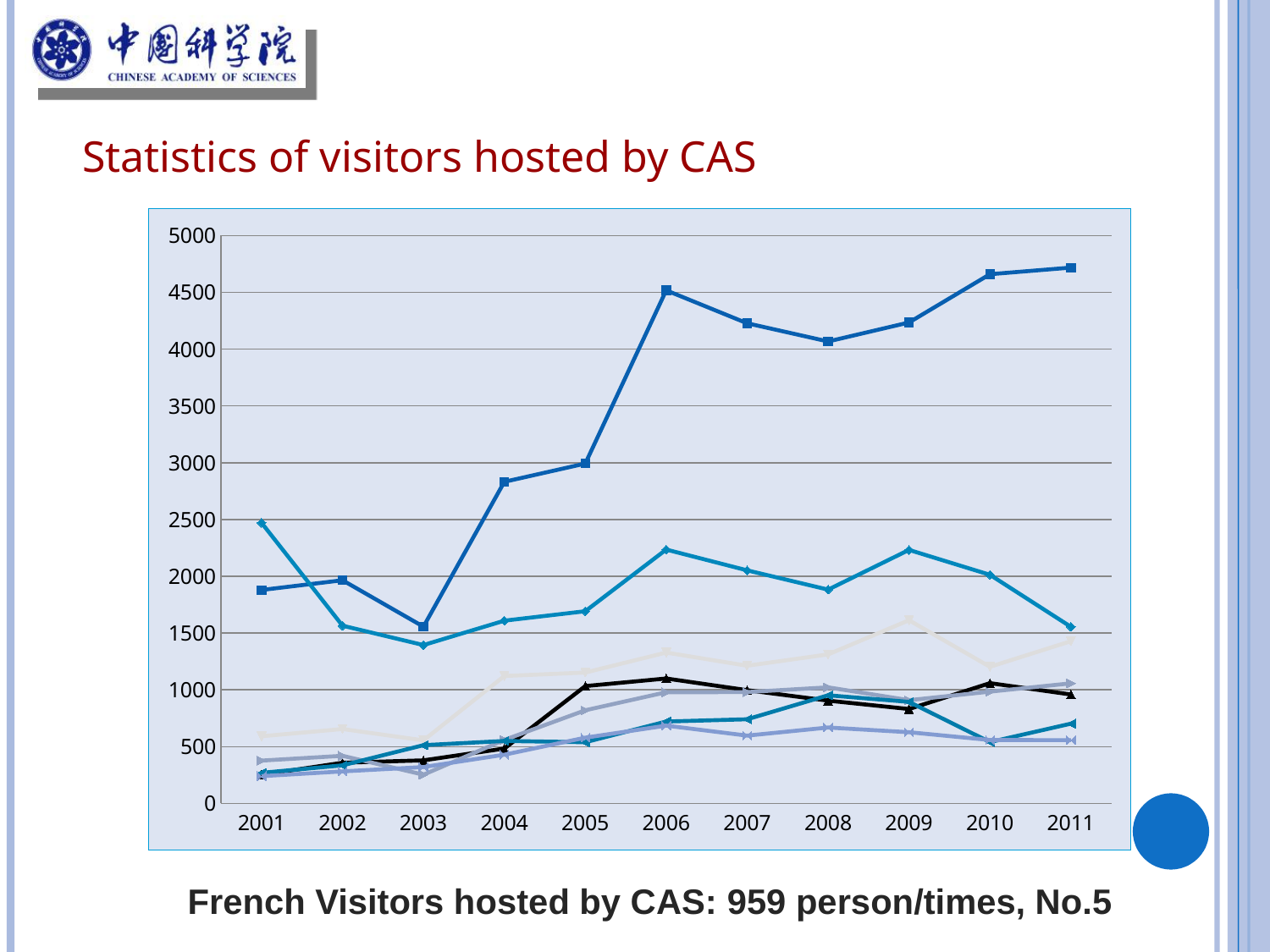
In which year does the teal line with diamond markers reach its highest value? 2001 Is the value of the dark blue line with square markers in 2001 greater or less than 2000? less Is the value of the teal line with diamond markers in 2011 greater or less than 2000? less What is the first year shown on the x axis of the chart? 2001 Is the value of the dark blue line with square markers in 2011 greater or less than 4500? greater Does the dark blue line with square markers rise or fall between 2004 and 2006? rise In 2011, is the dark blue line with square markers higher or lower than the teal line with diamond markers? higher What kind of chart is shown on the slide? line chart In which year does the dark blue line with square markers reach its lowest value? 2003 What is the highest value marked on the y axis of the chart? 5000 How many years are shown along the x axis of the chart? 11